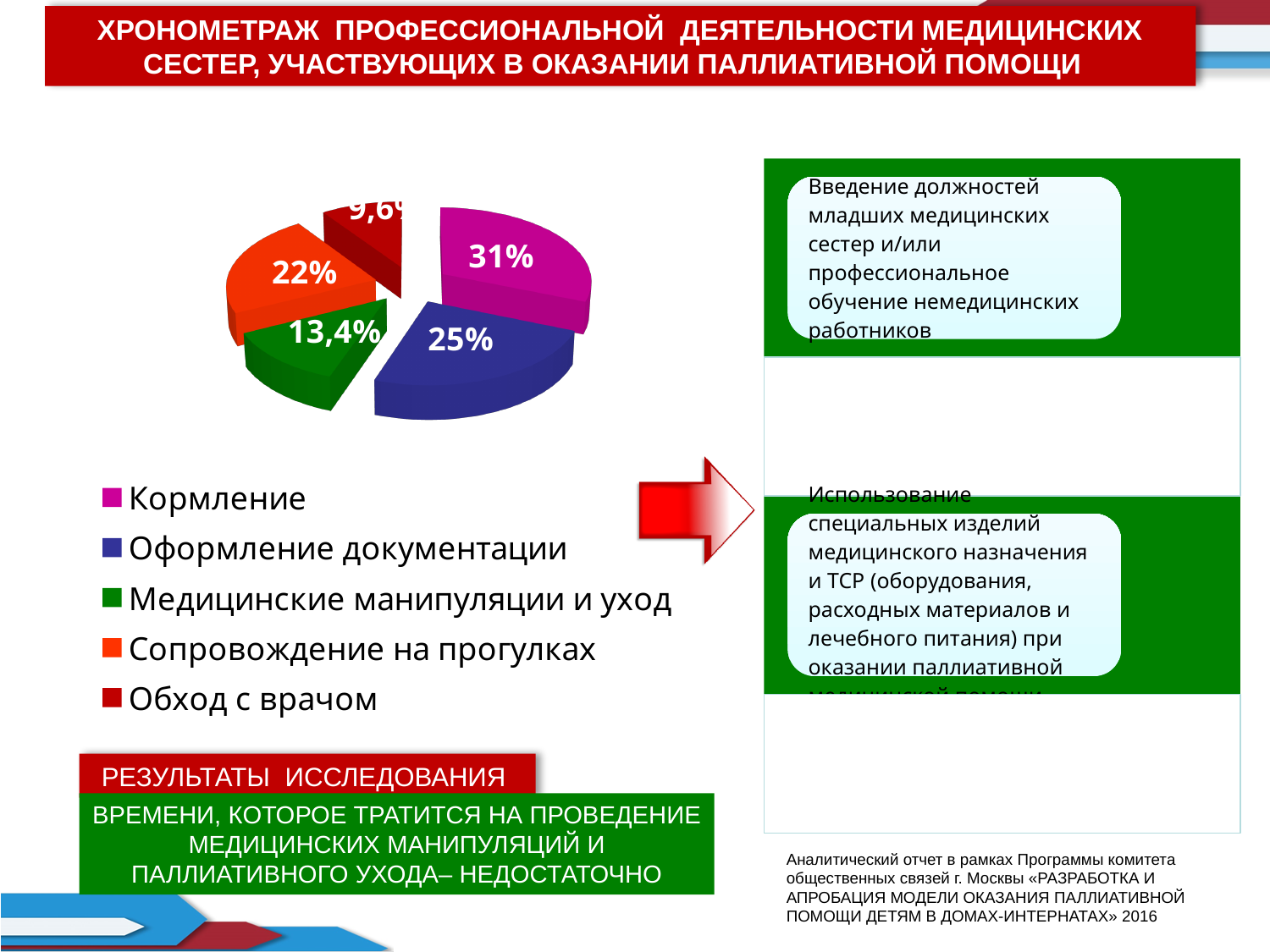
What percentage of the pie chart is labelled for Кормление? 31% Which category has the largest slice in the pie chart? Кормление Which is larger: the slice for Сопровождение на прогулках or the slice for Оформление документации? Оформление документации What percentage is labelled for Сопровождение на прогулках? 22% What is the difference in percentage points between Кормление and Оформление документации? 6% How many categories does the pie chart show? 5 What type of chart is shown on the slide? Pie chart What value is shown for Оформление документации in the pie chart? 25% What share does the pie chart show for Медицинские манипуляции и уход? 13,4% What is the difference between the Кормление slice and the Сопровождение на прогулках slice? 9% Which category is shown in red in the legend? Обход с врачом Which category has the smallest slice in the pie chart? Обход с врачом